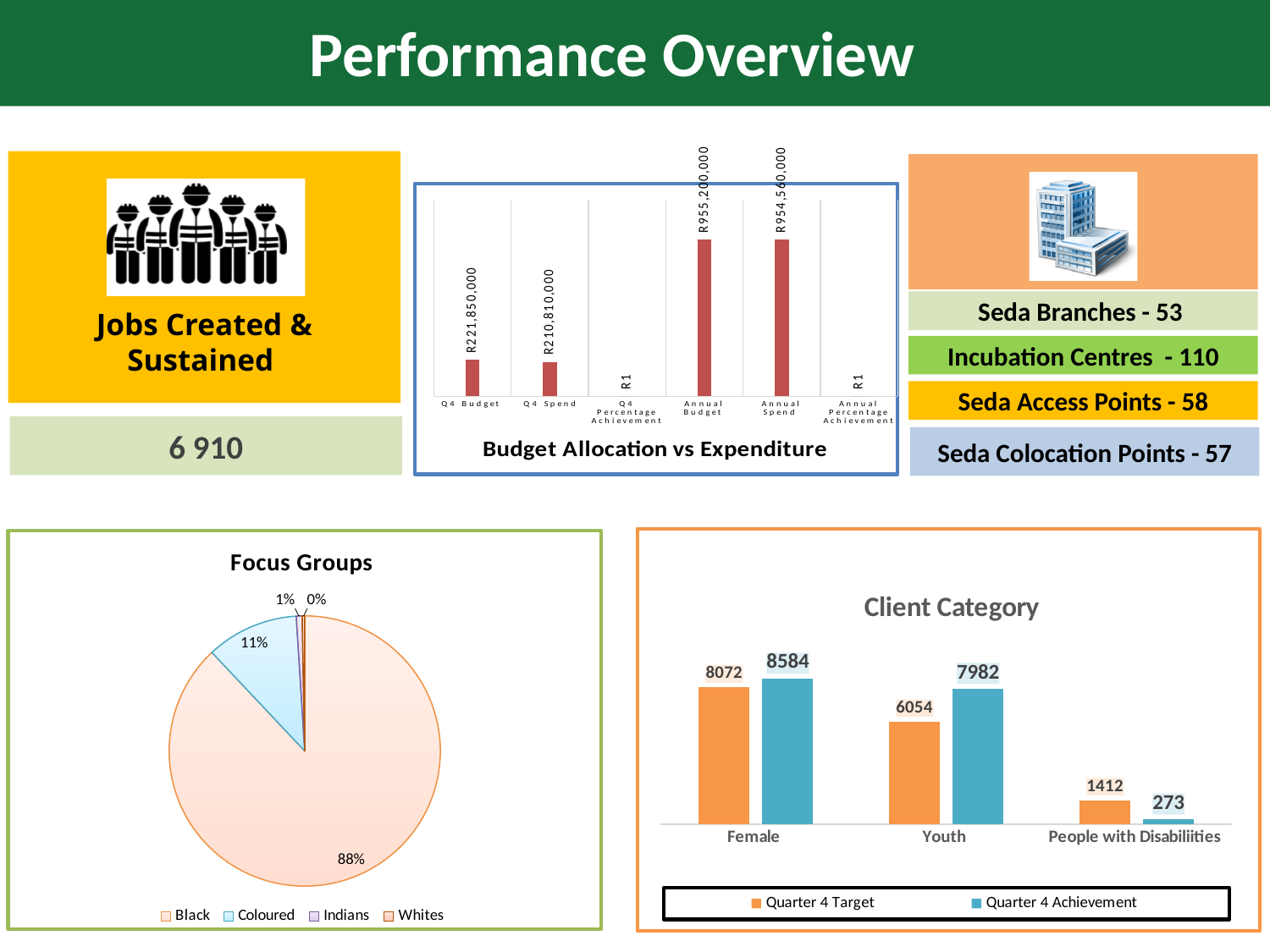
In the Client Category chart, what is the Quarter 4 Achievement value for Youth? 7982 In the Client Category chart, how many series does the legend list? 2 In the Budget Allocation vs Expenditure chart, how many categories are shown on the x axis? 6 In the Focus Groups pie chart, what share does Coloured have? 11% In the Budget Allocation vs Expenditure chart, what is the value for Annual Budget? R955,200,000 In the Budget Allocation vs Expenditure chart, what is the value for Q4 Spend? R210,810,000 In the Budget Allocation vs Expenditure chart, what is the difference between Q4 Budget and Q4 Spend? R11,040,000 In the Budget Allocation vs Expenditure chart, which category has the highest value? Annual Budget In the Client Category chart, what is the difference between the Quarter 4 Target and Quarter 4 Achievement for People with Disabilities? 1139 In the Client Category chart, which is larger for Female: Quarter 4 Target or Quarter 4 Achievement? Quarter 4 Achievement In the Focus Groups pie chart, how many groups are listed in the legend? 4 In the Focus Groups pie chart, what share does Black have? 88%